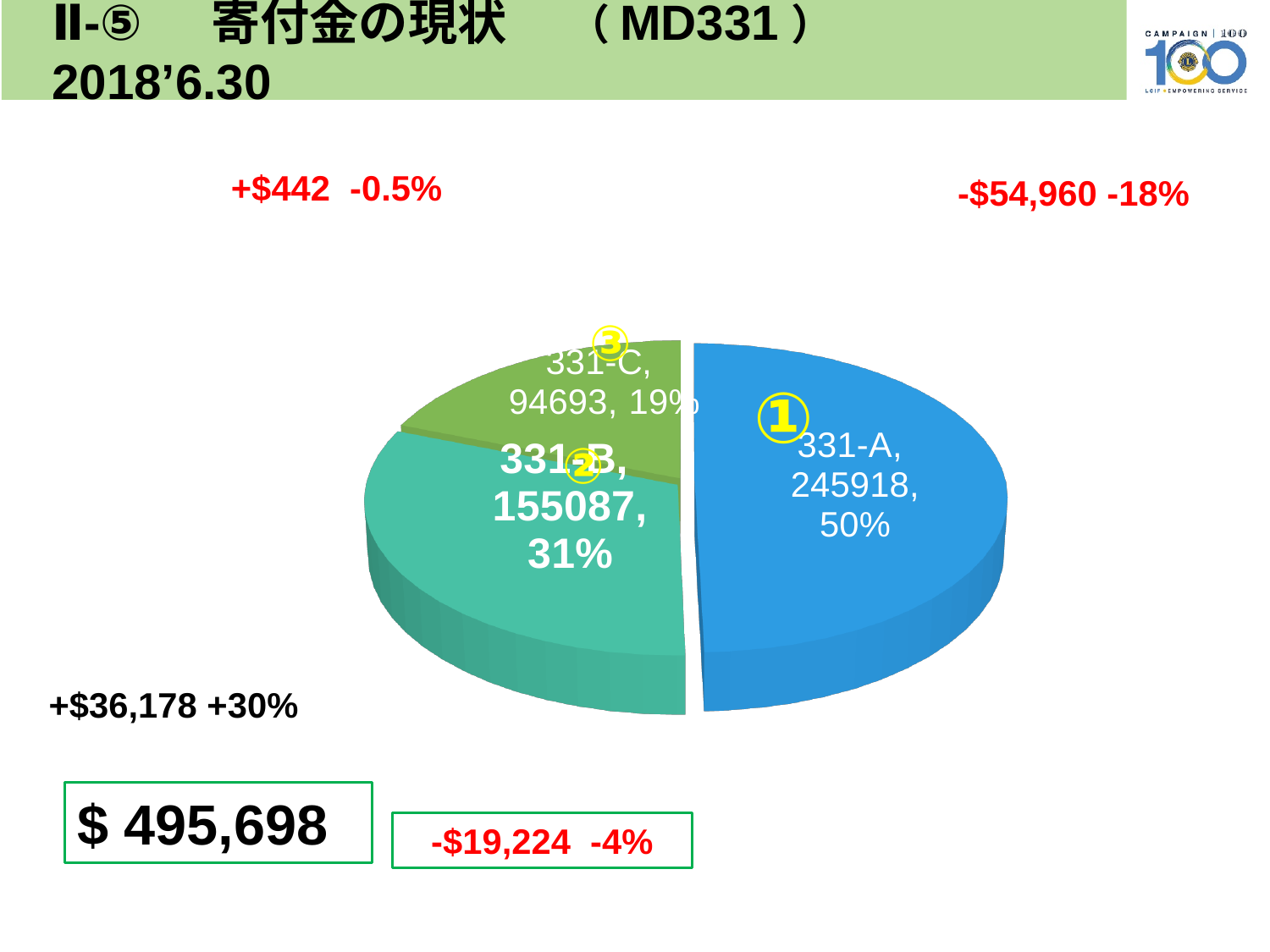
What share of the pie does 331-C represent? 19% Which is larger, the value for 331-B or the value for 331-C? 331-B What is the value shown for 331-C in the pie chart? 94693 Which slice of the pie chart is the smallest? 331-C Which slice of the pie chart is the largest? 331-A What is the value shown for 331-A in the pie chart? 245918 What is the difference between the values for 331-A and 331-B? 90831 What share of the pie does 331-A represent? 50% What is the value shown for 331-B in the pie chart? 155087 What colour is the 331-A slice of the pie chart? blue What kind of chart is shown on the slide? pie chart How many slices does the pie chart have? 3